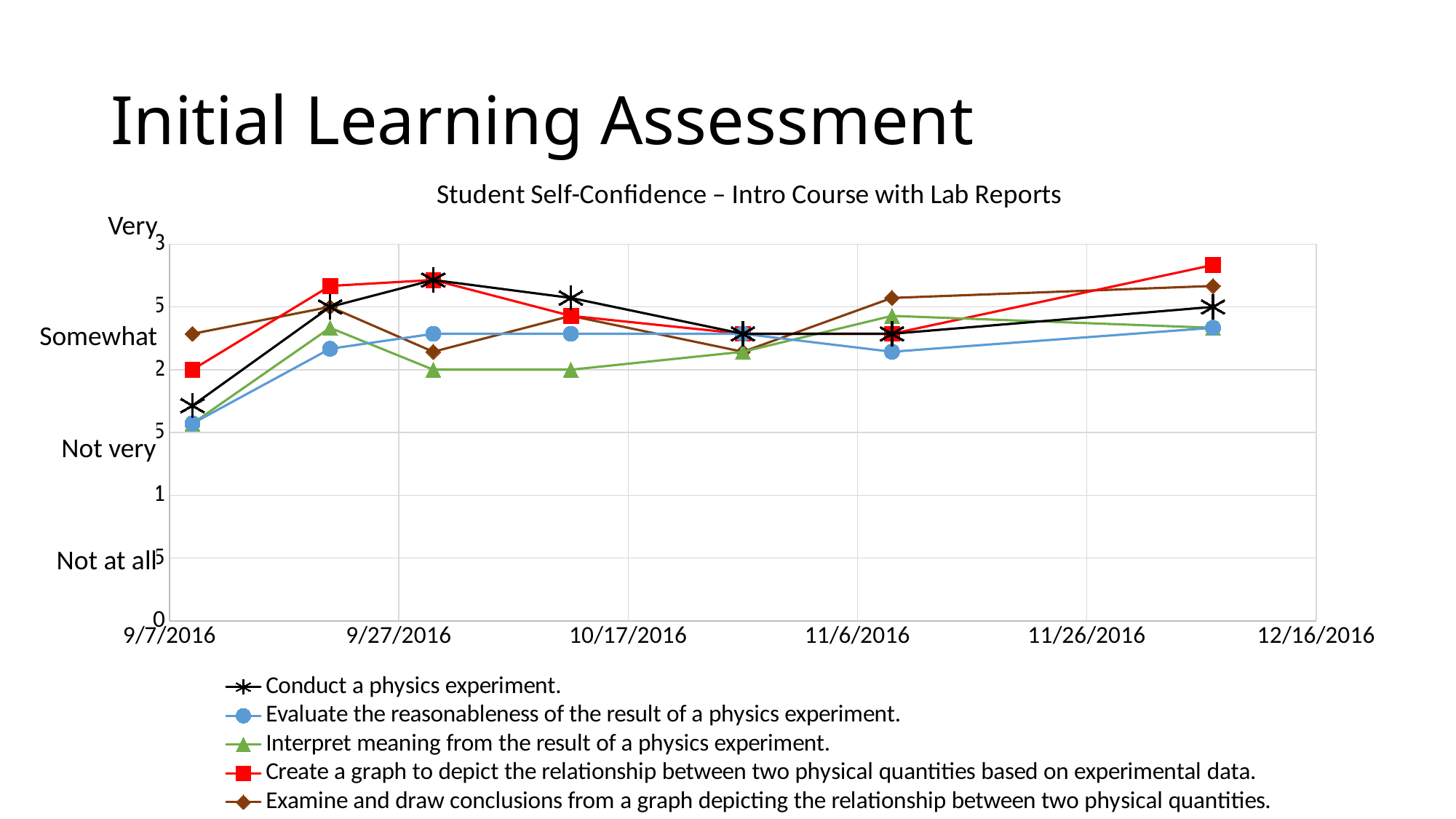
Is the value of the "Conduct a physics experiment." series at 9/7/2016 greater or less than 1.5? greater Is the value of the "Create a graph..." series at its final data point greater or less than 2.5? greater What is the title of the chart? Student Self-Confidence – Intro Course with Lab Reports Does the "Conduct a physics experiment." series rise or fall between its first and second data points? rise What kind of chart is shown on the slide? line chart What colour is the line for "Create a graph to depict the relationship between two physical quantities based on experimental data."? red At 9/7/2016, which is larger: the "Create a graph..." series or the "Conduct a physics experiment." series? Create a graph to depict the relationship between two physical quantities based on experimental data. What is the value of the "Create a graph..." series at 9/7/2016? 2 How many series does the legend list? 5 How many data points does each series have? 7 Which series has the highest value at the final data point? Create a graph to depict the relationship between two physical quantities based on experimental data. Is the value of the "Examine and draw conclusions..." series at 9/7/2016 greater or less than 2? greater